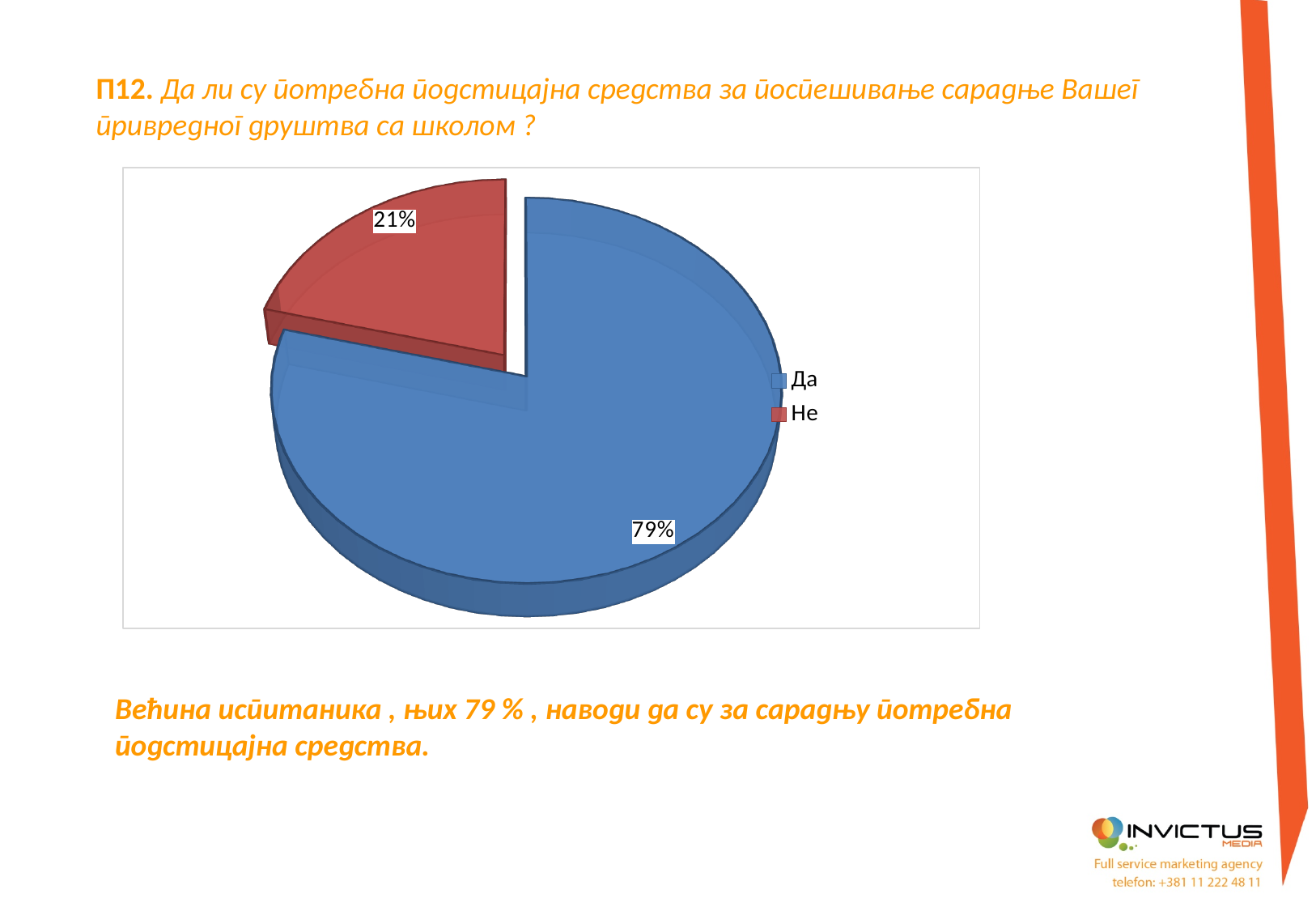
Which category has the smallest slice of the pie? Не What share of the pie does the "Да" slice represent? 79% What kind of chart is shown on the slide? Pie chart How many entries does the legend list? 2 What colour is the "Не" slice? Red How many slices does the pie chart have? 2 Which slice is larger, "Да" or "Не"? Да What share of the pie does the "Не" slice represent? 21% Which category has the largest slice of the pie? Да What colour is the "Да" slice? Blue What is the difference in percentage points between the "Да" and "Не" slices? 58